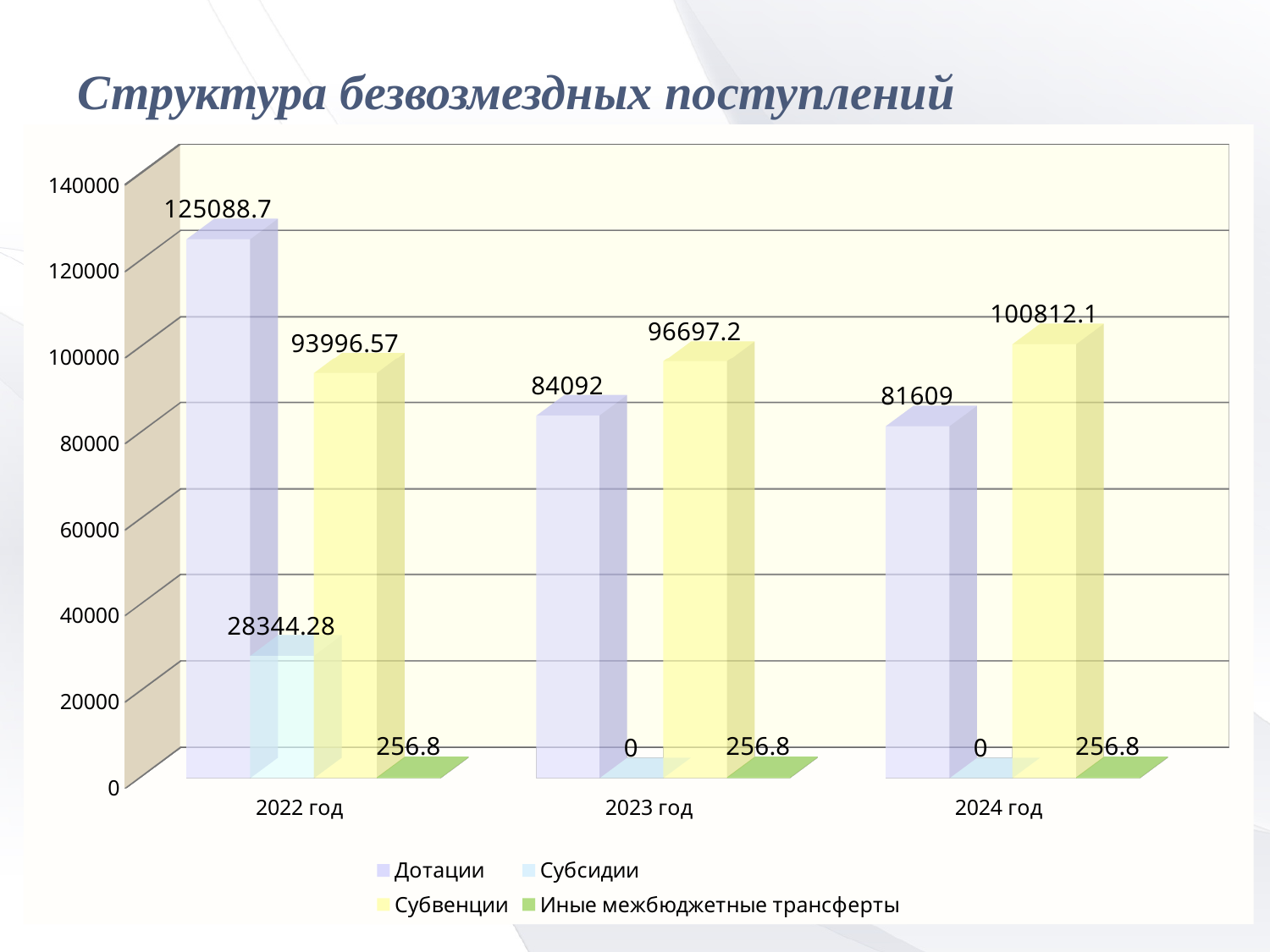
Which is larger in 2023 год: Дотации or Субвенции? Субвенции In which year is the value of Дотации highest? 2022 год How many years are shown on the x axis? 3 What is the difference between the Дотации values for 2022 год and 2023 год? 40996.7 What is the value of Субвенции for 2024 год? 100812.1 How many series does the legend list? 4 What kind of chart is shown on the slide? Bar chart In which year is the value of Субвенции lowest? 2022 год Do the values of Дотации rise or fall from 2022 год to 2024 год? Fall What is the value of Субсидии for 2022 год? 28344.28 What is the value of Иные межбюджетные трансферты for 2023 год? 256.8 What is the value of Дотации for 2022 год? 125088.7